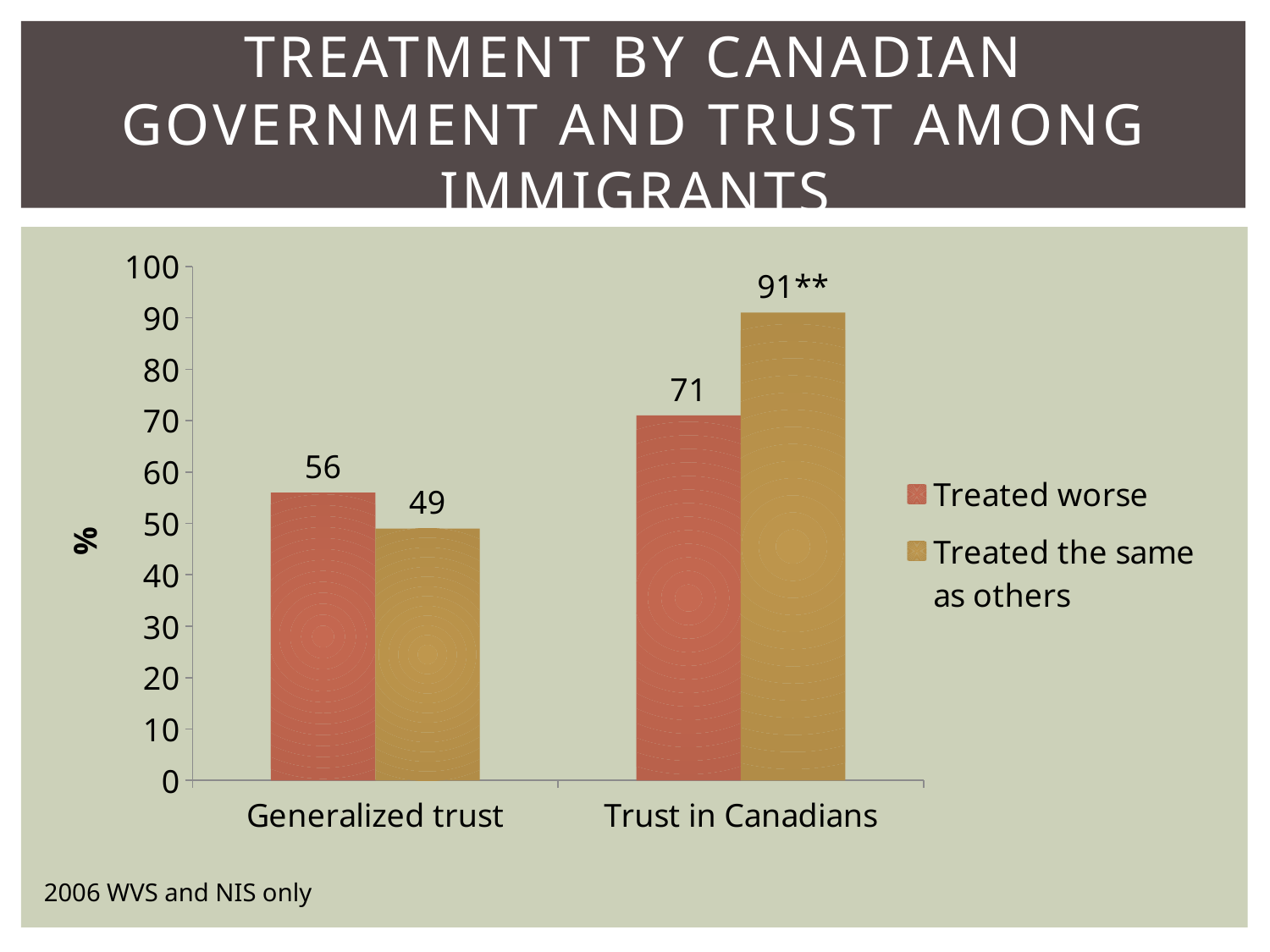
How many series does the legend list? 2 What is the value for "Treated the same as others" in the Generalized trust category? 49 How many categories are shown on the x axis? 2 What is the difference between the "Treated the same as others" and "Treated worse" values for Trust in Canadians? 20 What is the value for "Treated worse" in the Trust in Canadians category? 71 Which bar has the lowest value on the chart? Treated the same as others, Generalized trust What kind of chart is shown on the slide? Bar chart What is the difference between the "Treated worse" and "Treated the same as others" values for Generalized trust? 7 Which bar has the highest value on the chart? Treated the same as others, Trust in Canadians What is the value for "Treated worse" in the Generalized trust category? 56 For Trust in Canadians, which series has the larger value: "Treated worse" or "Treated the same as others"? Treated the same as others What data label is shown for "Treated the same as others" in the Trust in Canadians category? 91**